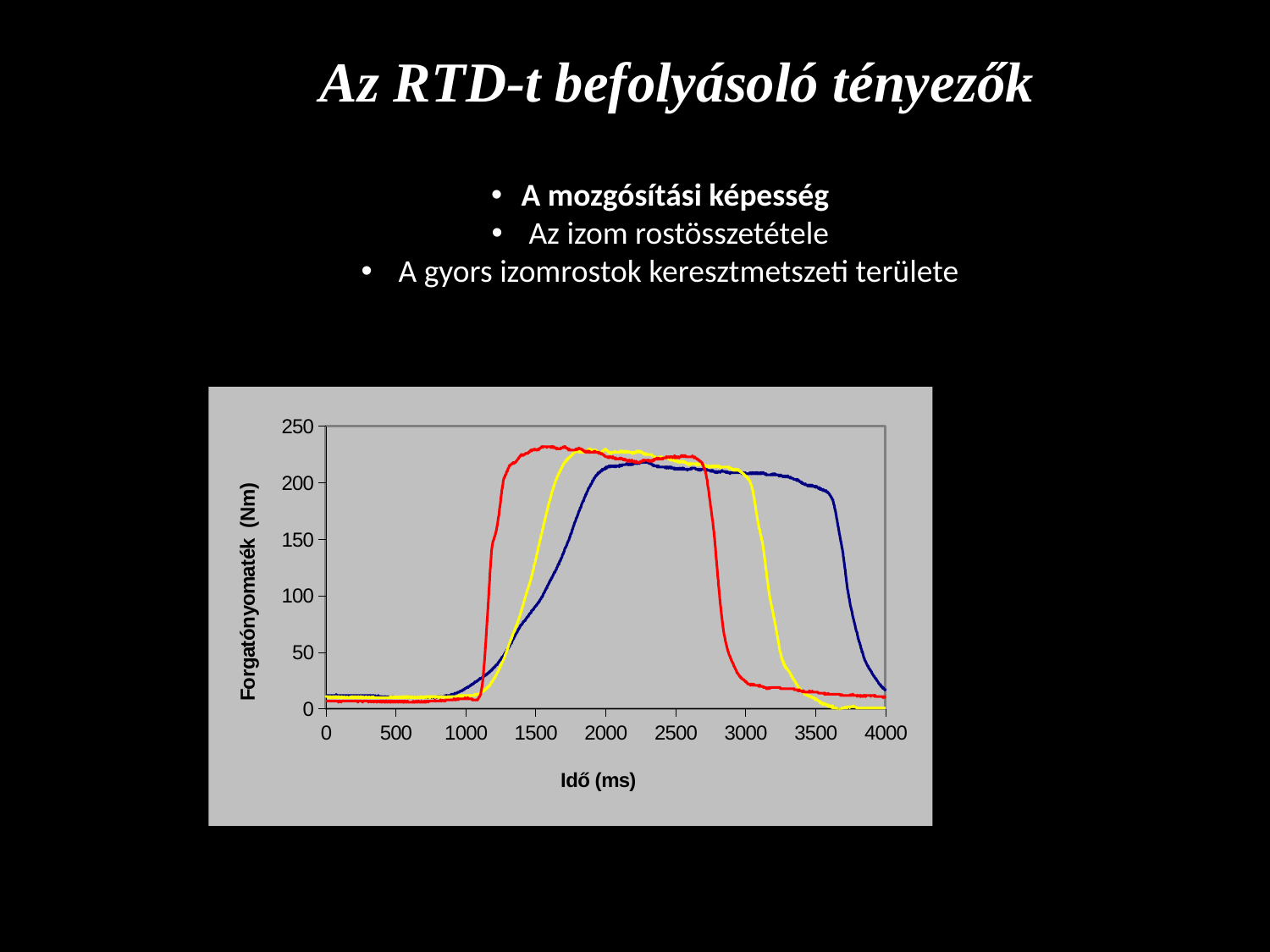
Is the value of the red line at 3000 ms greater or less than 50? less Is the value of the blue line at 1000 ms greater or less than 50? less Which line is the first to rise from its baseline along the x axis? blue line At 3500 ms, which line has the larger value, the blue line or the red line? blue line What is the title of the x axis of the chart? Idő (ms) What is the title of the y axis of the chart? Forgatónyomaték (Nm) Is the value of the blue line at 3000 ms greater or less than 150? greater What kind of chart is shown on the slide? line chart At 1500 ms, which line has the larger value, the red line or the blue line? red line How many lines are plotted on the chart? 3